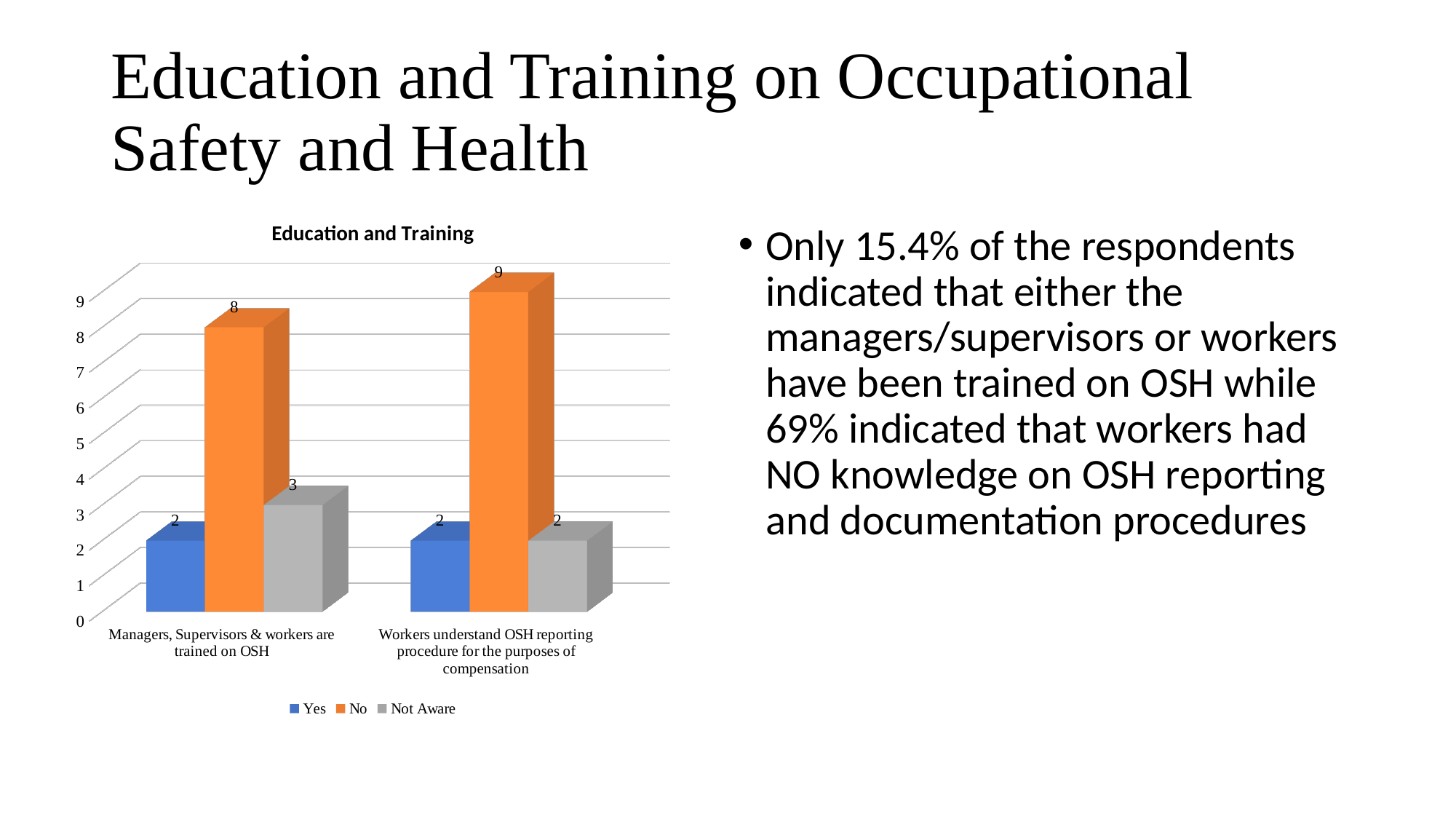
What type of chart is shown on the slide? Bar chart Which series has the highest value for "Managers, Supervisors & workers are trained on OSH"? No Which category has the larger "No" value? Workers understand OSH reporting procedure for the purposes of compensation What is the title of the chart? Education and Training How many series does the chart legend list? 3 What is the value of the "Yes" series for "Workers understand OSH reporting procedure for the purposes of compensation"? 2 What is the value of the "No" series for "Managers, Supervisors & workers are trained on OSH"? 8 What is the value of the "No" series for "Workers understand OSH reporting procedure for the purposes of compensation"? 9 Which series has the lowest value for "Managers, Supervisors & workers are trained on OSH"? Yes How many categories are shown on the x axis of the chart? 2 What is the difference between the "No" and "Yes" values for "Workers understand OSH reporting procedure for the purposes of compensation"? 7 What is the value of the "Not Aware" series for "Managers, Supervisors & workers are trained on OSH"? 3